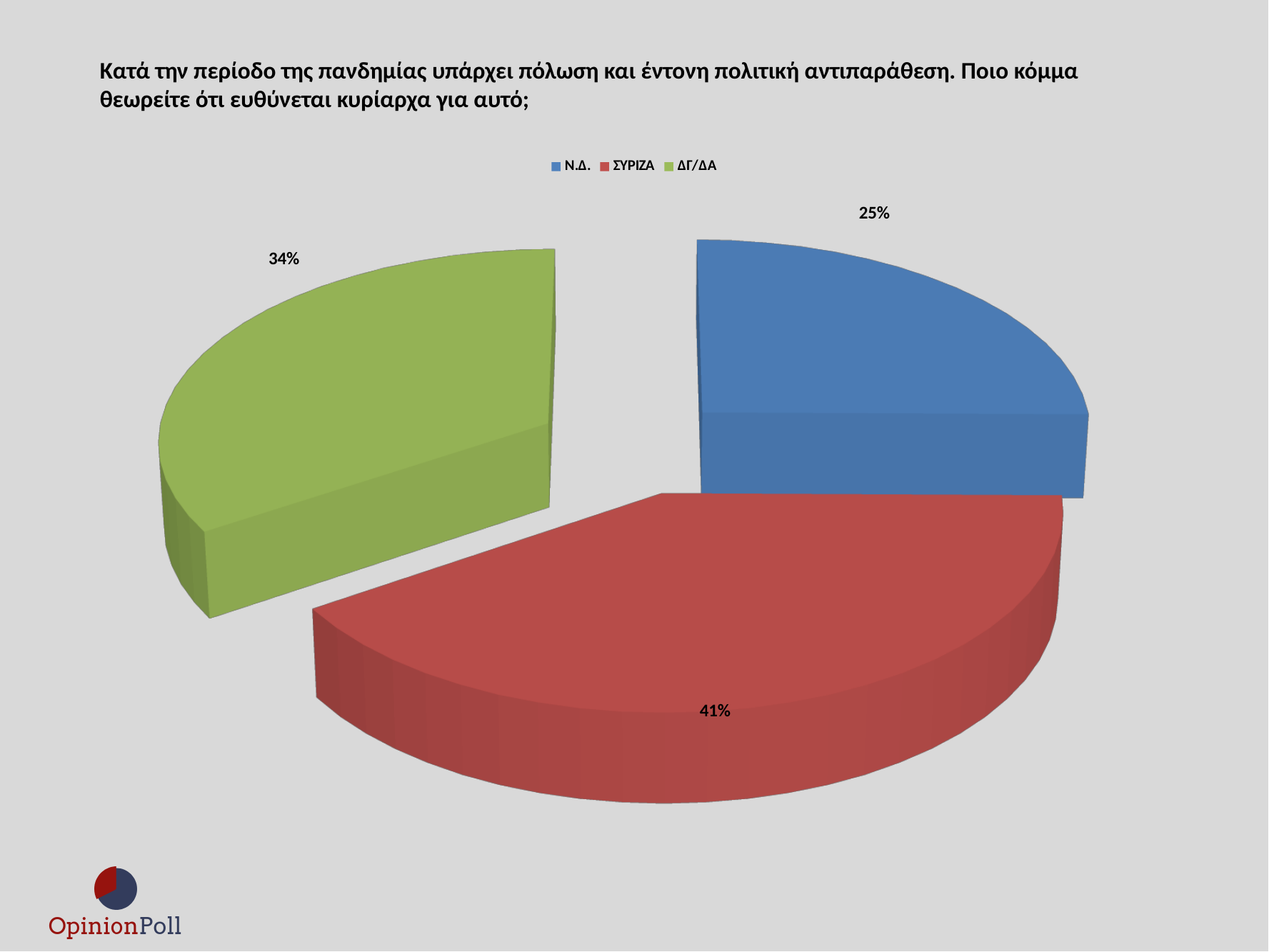
How many slices does the pie chart have? 3 Which is larger, the ΔΓ/ΔΑ slice or the Ν.Δ. slice? ΔΓ/ΔΑ Which is larger, the ΣΥΡΙΖΑ slice or the ΔΓ/ΔΑ slice? ΣΥΡΙΖΑ Which category has the largest slice of the pie? ΣΥΡΙΖΑ What percentage of the pie is attributed to Ν.Δ.? 25% What percentage of the pie is attributed to ΣΥΡΙΖΑ? 41% Which category has the smallest slice of the pie? Ν.Δ. What is the difference in percentage points between the ΔΓ/ΔΑ slice and the Ν.Δ. slice? 9 What is the difference in percentage points between the ΣΥΡΙΖΑ slice and the Ν.Δ. slice? 16 What percentage of the pie is attributed to ΔΓ/ΔΑ? 34% What kind of chart is shown on the slide? Pie chart What colour is the ΣΥΡΙΖΑ slice in the pie chart? Red